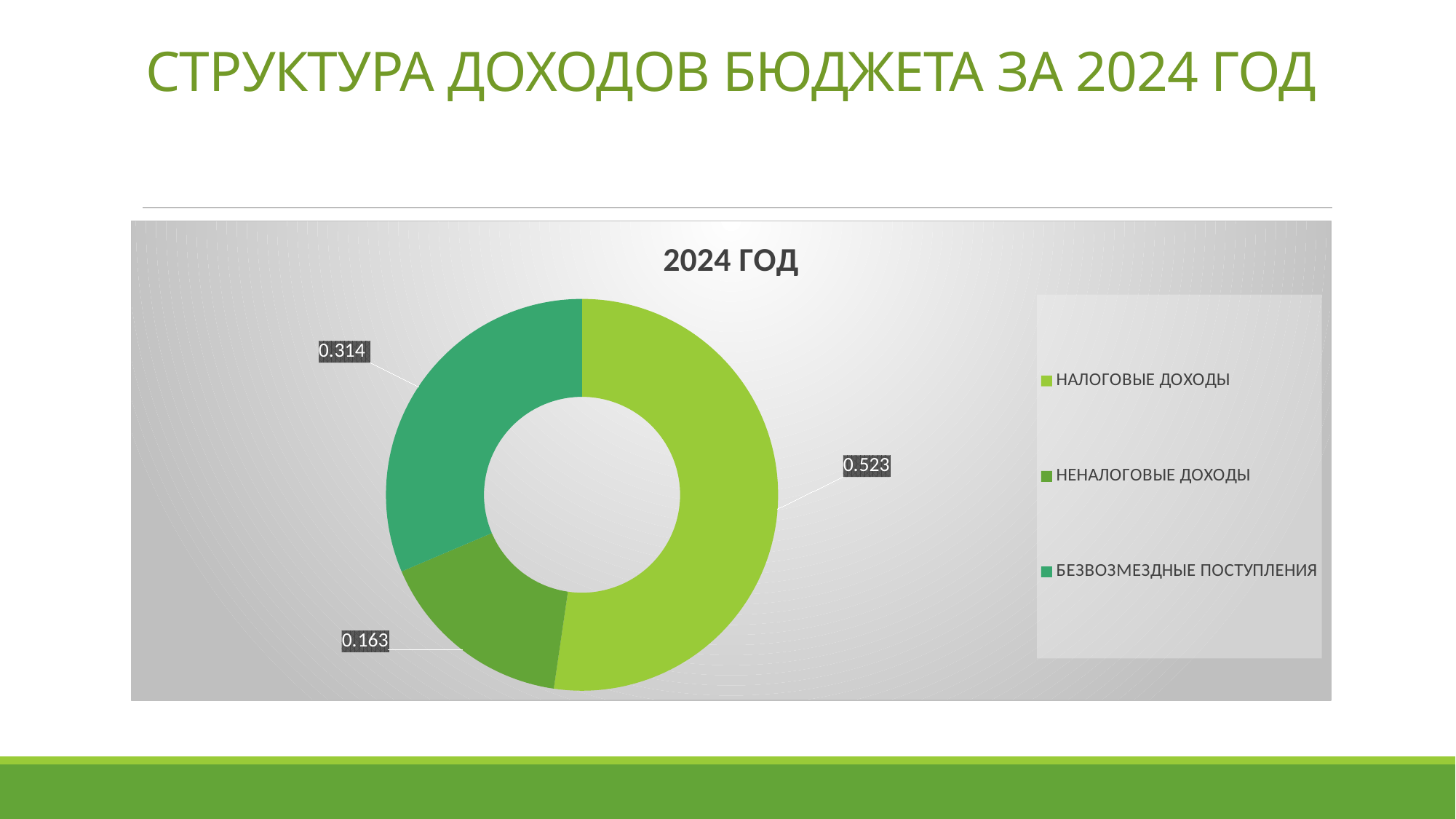
How many categories are shown in the chart? 3 How many entries does the chart legend list? 3 Which is larger, the value for БЕЗВОЗМЕЗДНЫЕ ПОСТУПЛЕНИЯ or the value for НЕНАЛОГОВЫЕ ДОХОДЫ? БЕЗВОЗМЕЗДНЫЕ ПОСТУПЛЕНИЯ What kind of chart is shown on the slide? Doughnut (pie) chart Which category has the largest share in the chart? НАЛОГОВЫЕ ДОХОДЫ What is the value for НАЛОГОВЫЕ ДОХОДЫ in the chart? 0.523 Which category has the smallest share in the chart? НЕНАЛОГОВЫЕ ДОХОДЫ What is the difference between the values for НАЛОГОВЫЕ ДОХОДЫ and БЕЗВОЗМЕЗДНЫЕ ПОСТУПЛЕНИЯ? 0.209 What is the title of the chart? 2024 ГОД What is the value for НЕНАЛОГОВЫЕ ДОХОДЫ in the chart? 0.163 What is the difference between the values for БЕЗВОЗМЕЗДНЫЕ ПОСТУПЛЕНИЯ and НЕНАЛОГОВЫЕ ДОХОДЫ? 0.151 What is the value for БЕЗВОЗМЕЗДНЫЕ ПОСТУПЛЕНИЯ in the chart? 0.314